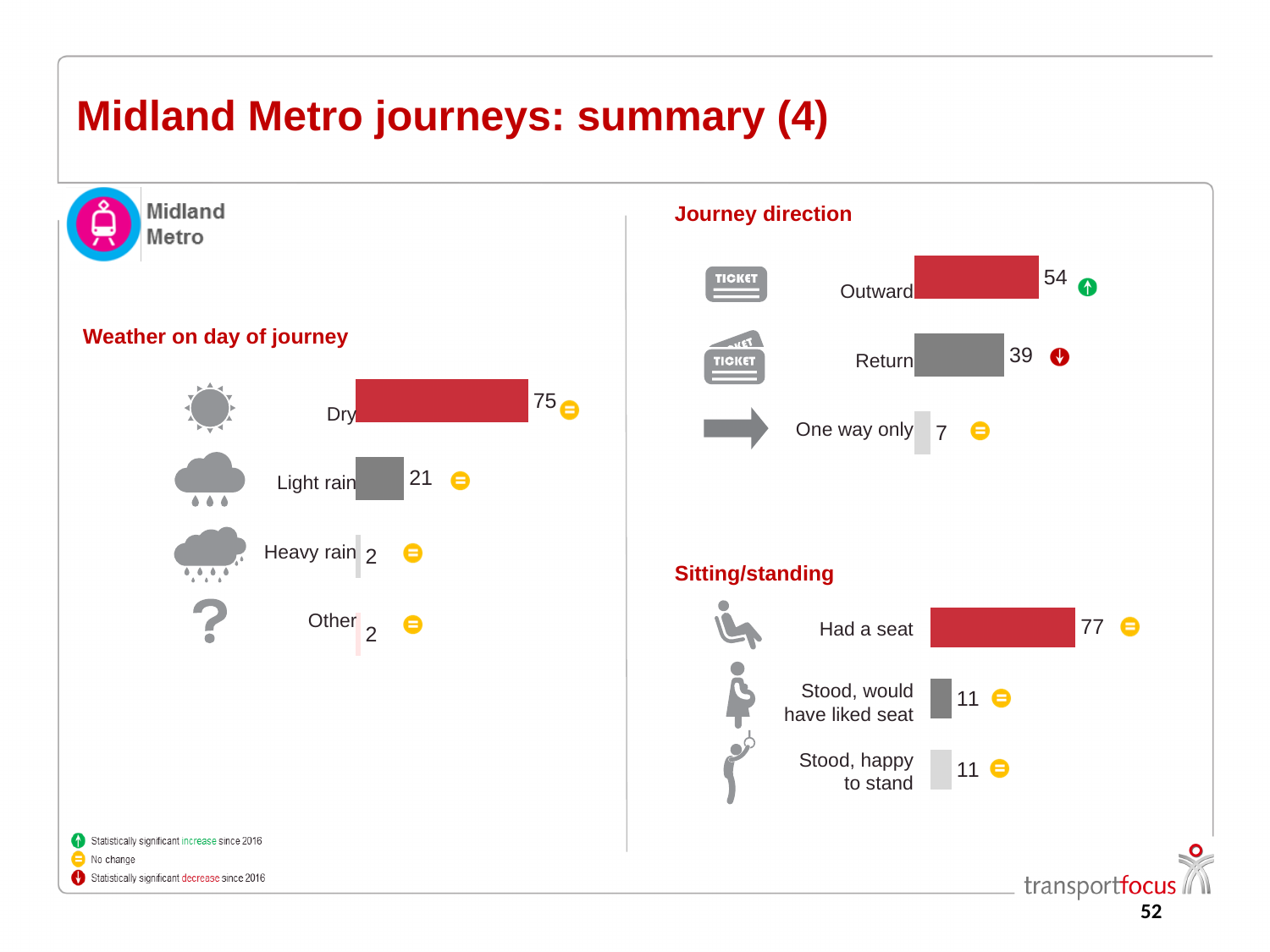
In the 'Journey direction' chart, which category has the lowest value? One way only In the 'Weather on day of journey' chart, which category has the highest value? Dry In the 'Journey direction' chart, what is the difference between Outward and Return? 15 In the 'Sitting/standing' chart, what is the value for Had a seat? 77 In the 'Weather on day of journey' chart, what is the difference between Dry and Light rain? 54 What kind of chart is the 'Sitting/standing' chart? Bar chart In the 'Journey direction' chart, what is the value for Return? 39 In the 'Weather on day of journey' chart, how many categories are shown? 4 In the 'Weather on day of journey' chart, what is the value for Dry? 75 In the 'Sitting/standing' chart, what is the value for 'Stood, happy to stand'? 11 In the 'Weather on day of journey' chart, what is the value for Light rain? 21 In the 'Journey direction' chart, which is larger, Outward or Return? Outward